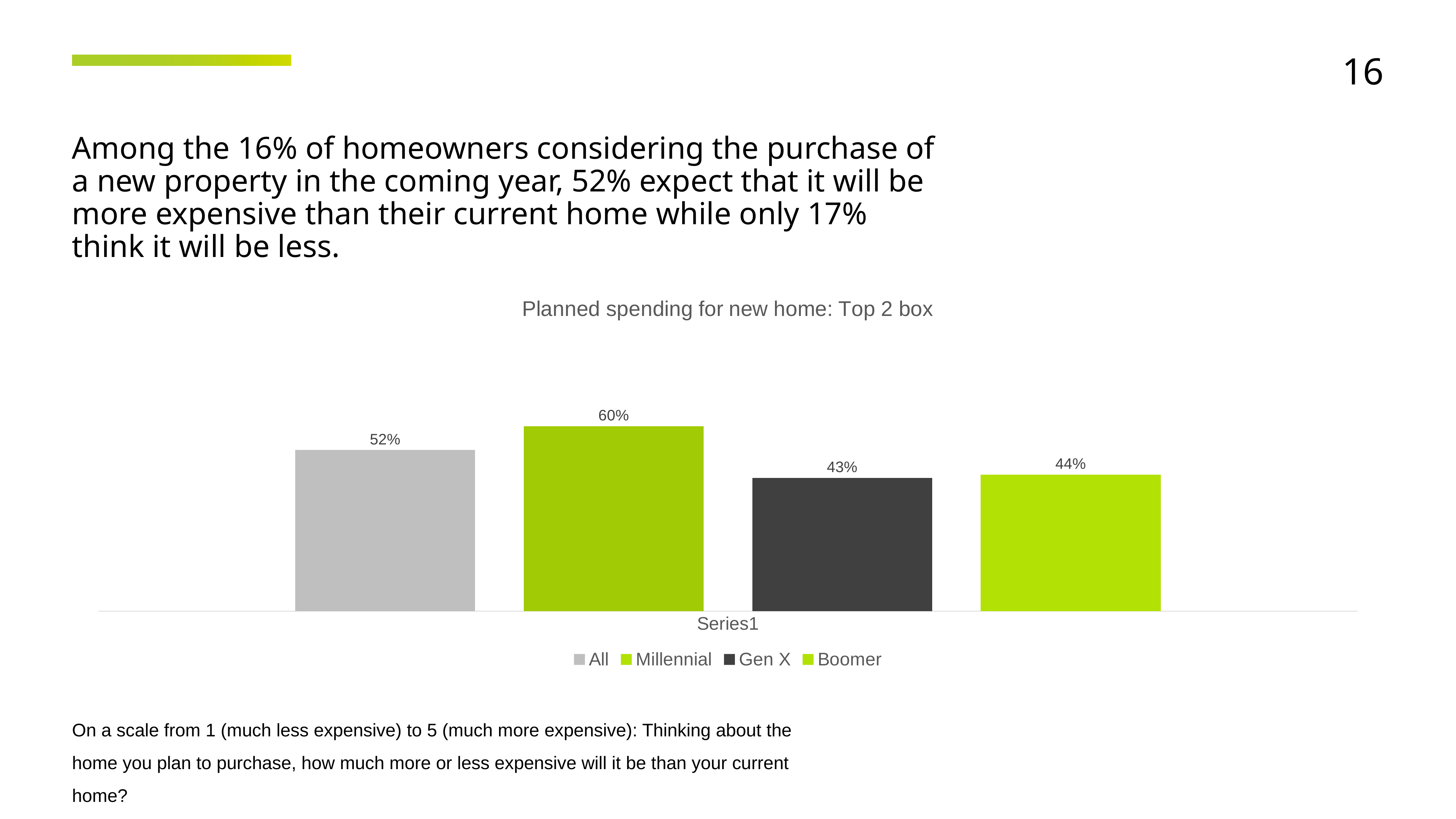
What is the value for All in the chart? 52% What is the difference between the Millennial and All values? 8% What is the title of the chart? Planned spending for new home: Top 2 box What is the value for Boomer in the chart? 44% What is the value for Millennial in the chart? 60% What is the value for Gen X in the chart? 43% What kind of chart is shown on the slide? Bar chart Which group has the lowest value in the chart? Gen X Which group has the highest value in the chart? Millennial How many series does the legend list? 4 Which is larger, the value for All or the value for Boomer? All What is the difference between the Millennial and Gen X values? 17%